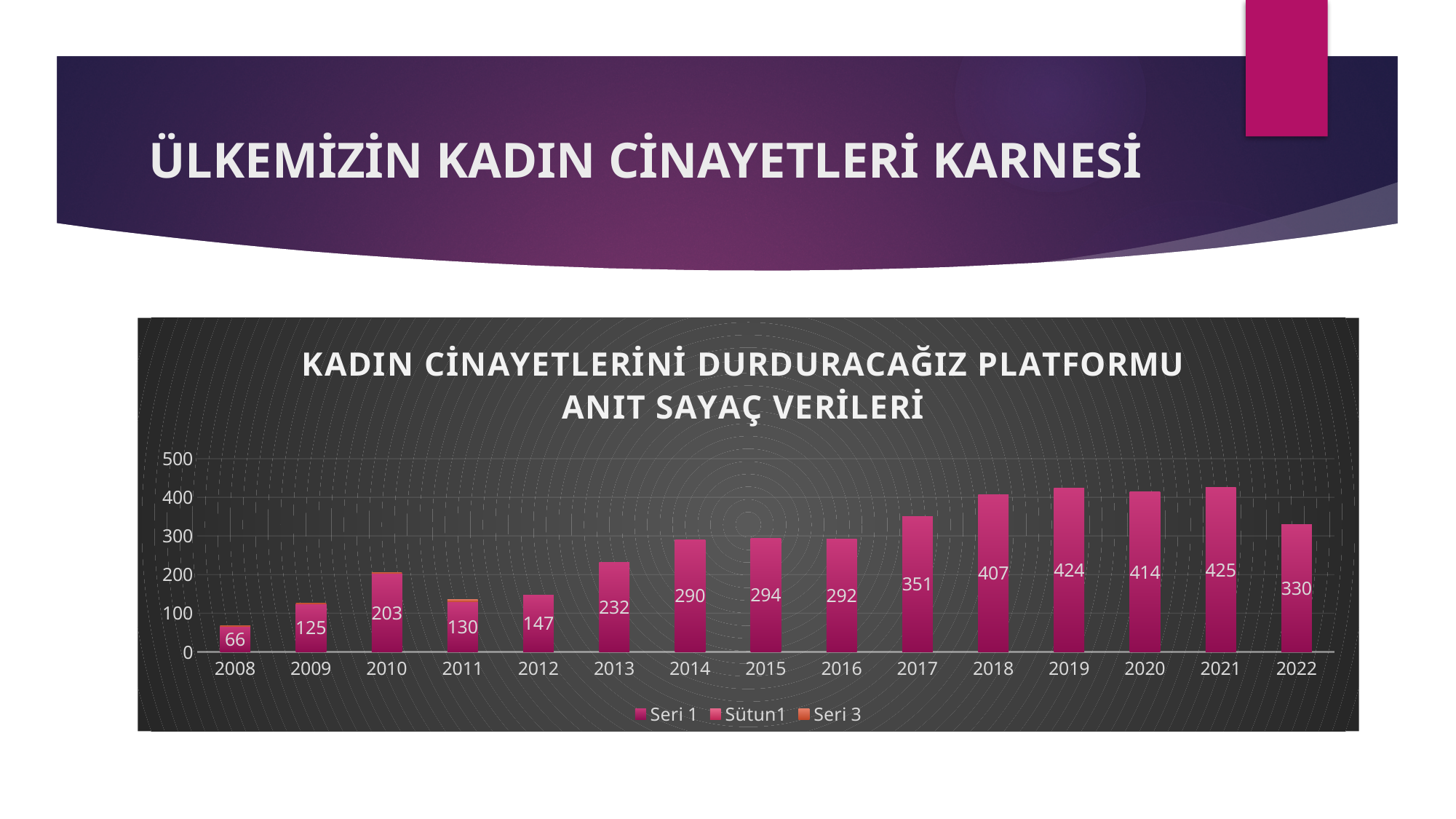
What is the title of the chart? KADIN CİNAYETLERİNİ DURDURACAĞIZ PLATFORMU ANIT SAYAÇ VERİLERİ What is the value for 2008? 66 How many years are shown on the x axis? 15 Which is larger, the value for 2010 or the value for 2011? 2010 Is the value for 2019 greater or less than 400? greater What is the value for 2017? 351 What is the value for 2022? 330 Which year has the lowest value? 2008 What is the difference between the values for 2018 and 2013? 175 What kind of chart is shown on the slide? bar chart Which year has the highest value? 2021 How many series does the legend list? 3